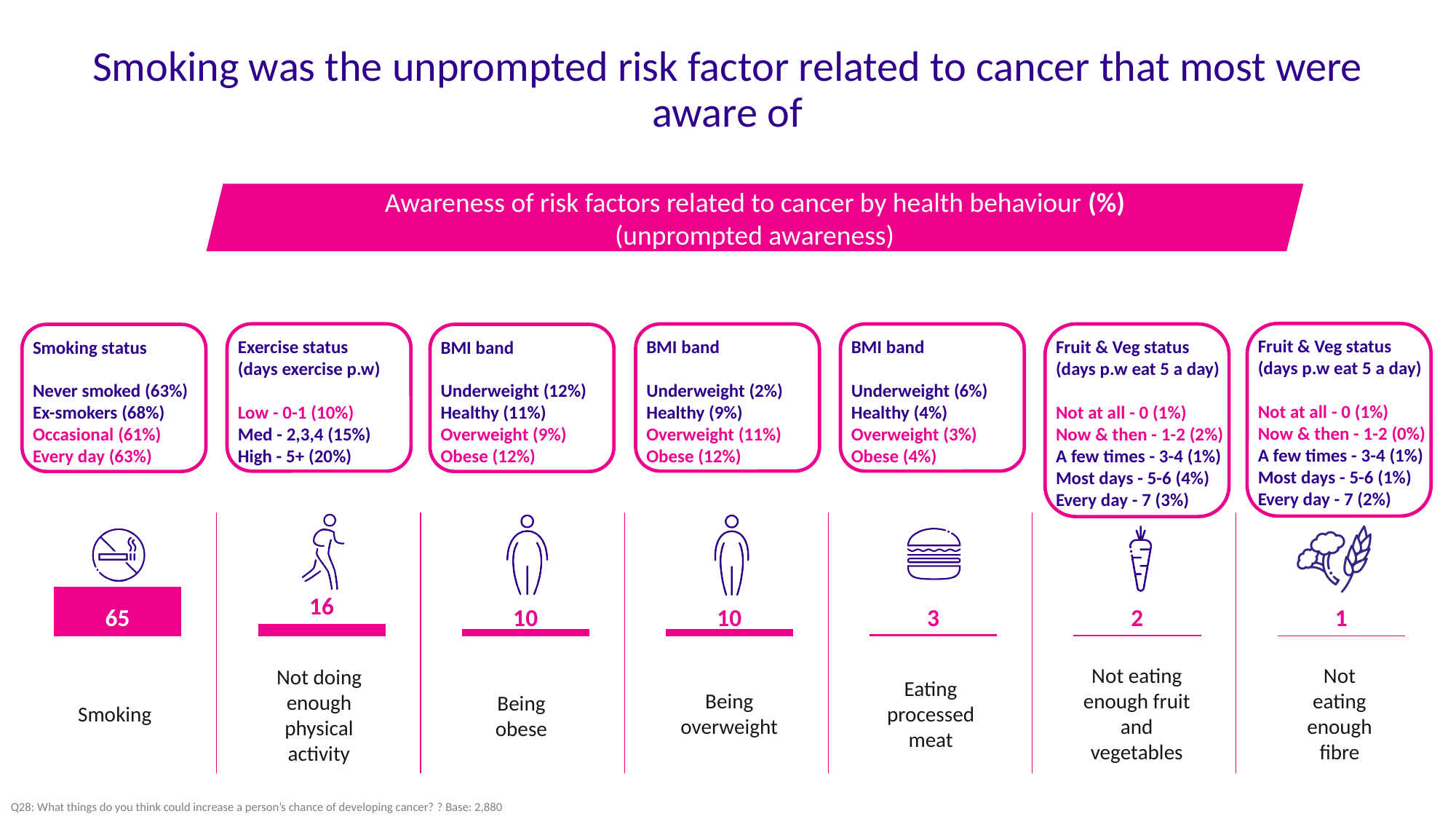
Which risk factor has the lowest awareness value? Not eating enough fibre What is the value for Eating processed meat? 3 What is the value for Not eating enough fibre? 1 What is the difference between the values for Smoking and Not doing enough physical activity? 49 How many risk factor categories are shown in the chart? 7 What is the difference between the values for Eating processed meat and Not eating enough fruit and vegetables? 1 What is the value for Smoking in the awareness of risk factors chart? 65 Which is larger, the value for Not doing enough physical activity or the value for Being obese? Not doing enough physical activity What kind of chart is used to show awareness of risk factors? Bar chart Which risk factor has the highest awareness value? Smoking What is the title of the chart? Awareness of risk factors related to cancer by health behaviour (%) (unprompted awareness) What is the value for Not doing enough physical activity? 16